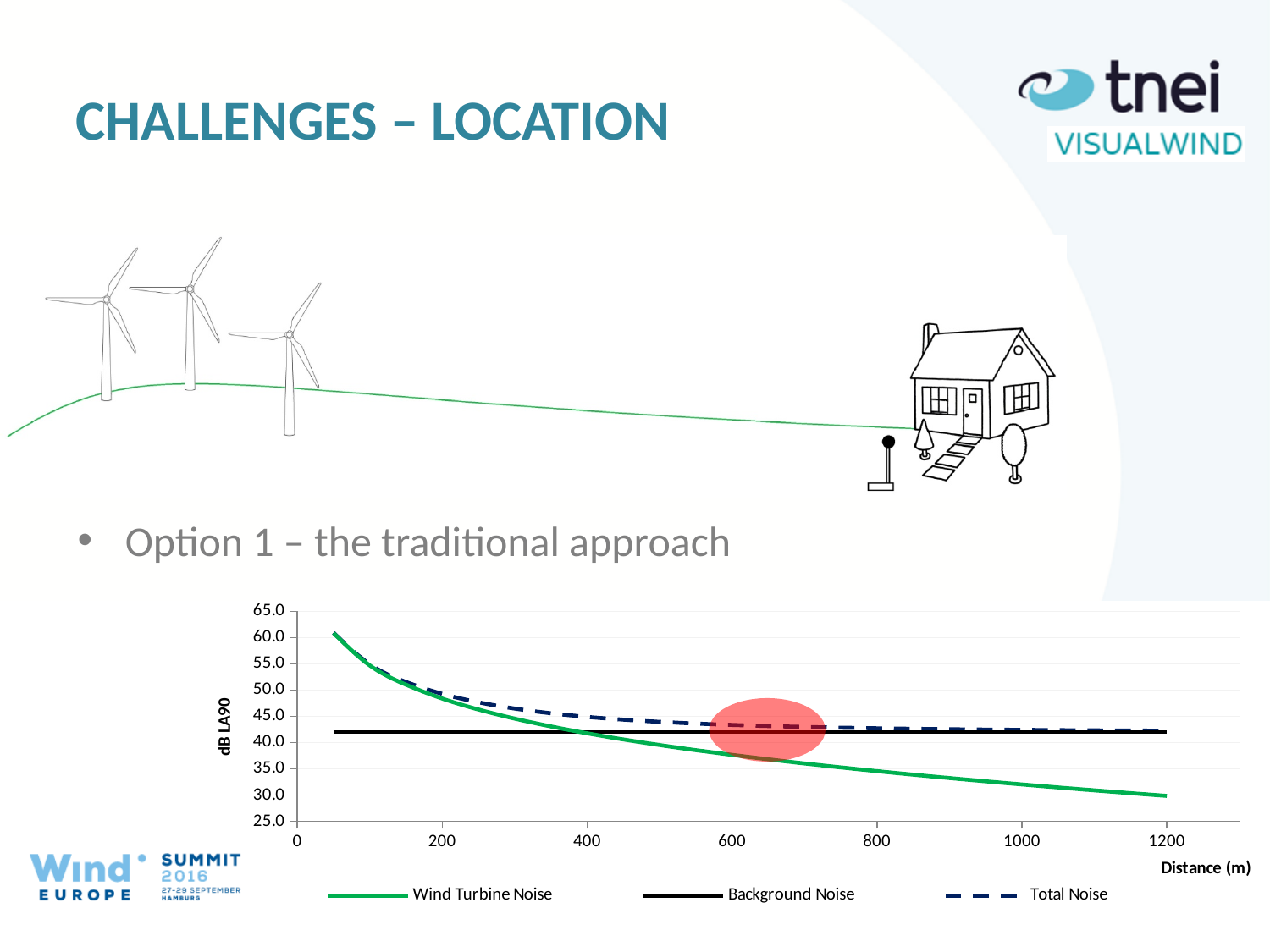
Is the Wind Turbine Noise value at 200 m greater or less than 45.0? greater What is the label of the chart's vertical axis? dB LA90 Does the Wind Turbine Noise series rise or fall as distance increases? fall What is the label of the chart's horizontal axis? Distance (m) At 200 m, which is larger: Wind Turbine Noise or Background Noise? Wind Turbine Noise What kind of chart is shown on the slide? line chart At 1000 m, which is larger: Total Noise or Wind Turbine Noise? Total Noise How many series does the chart legend list? 3 Is the Wind Turbine Noise value at 1200 m greater or less than 35.0? less Is the Total Noise value at 1200 m greater or less than 40.0? greater